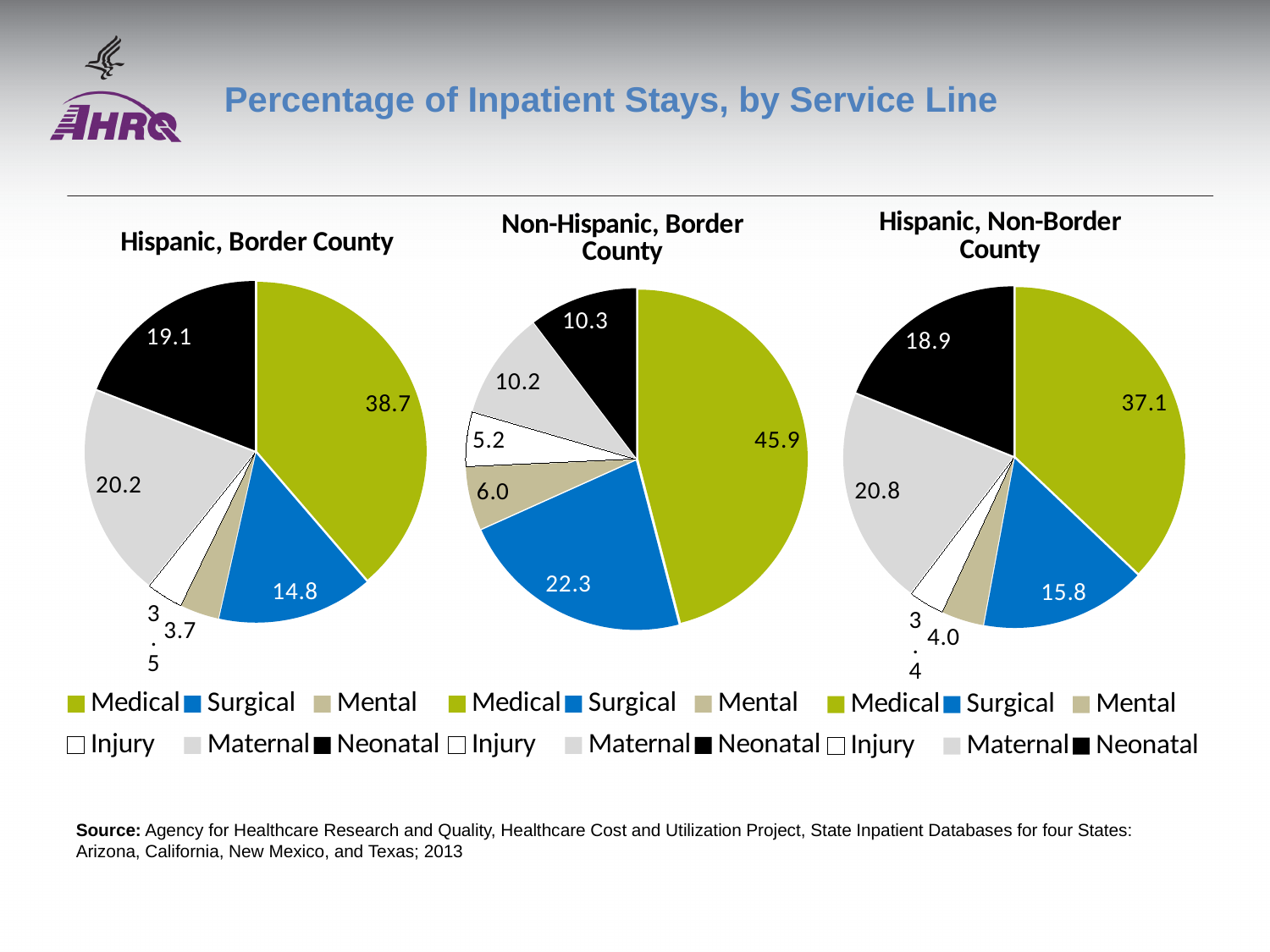
In the Hispanic, Border County chart, what is the difference between the Maternal and Neonatal values? 1.1 What kind of chart is used on this slide? Pie chart In the Non-Hispanic, Border County chart, what is the value for Surgical? 22.3 How many service lines does the legend list for each pie chart? 6 In the Hispanic, Non-Border County chart, which service line has the smallest share? Injury In the Non-Hispanic, Border County chart, which service line has the largest share? Medical In the Non-Hispanic, Border County chart, what is the difference between the Medical and Surgical values? 23.6 In the Hispanic, Border County chart, what percentage of inpatient stays is Medical? 38.7 Which is larger in the Hispanic, Non-Border County chart: Surgical or Neonatal? Neonatal In the Hispanic, Non-Border County chart, what is the value for Maternal? 20.8 What colour represents Neonatal in the legend? Black How many pie charts are shown on the slide? 3